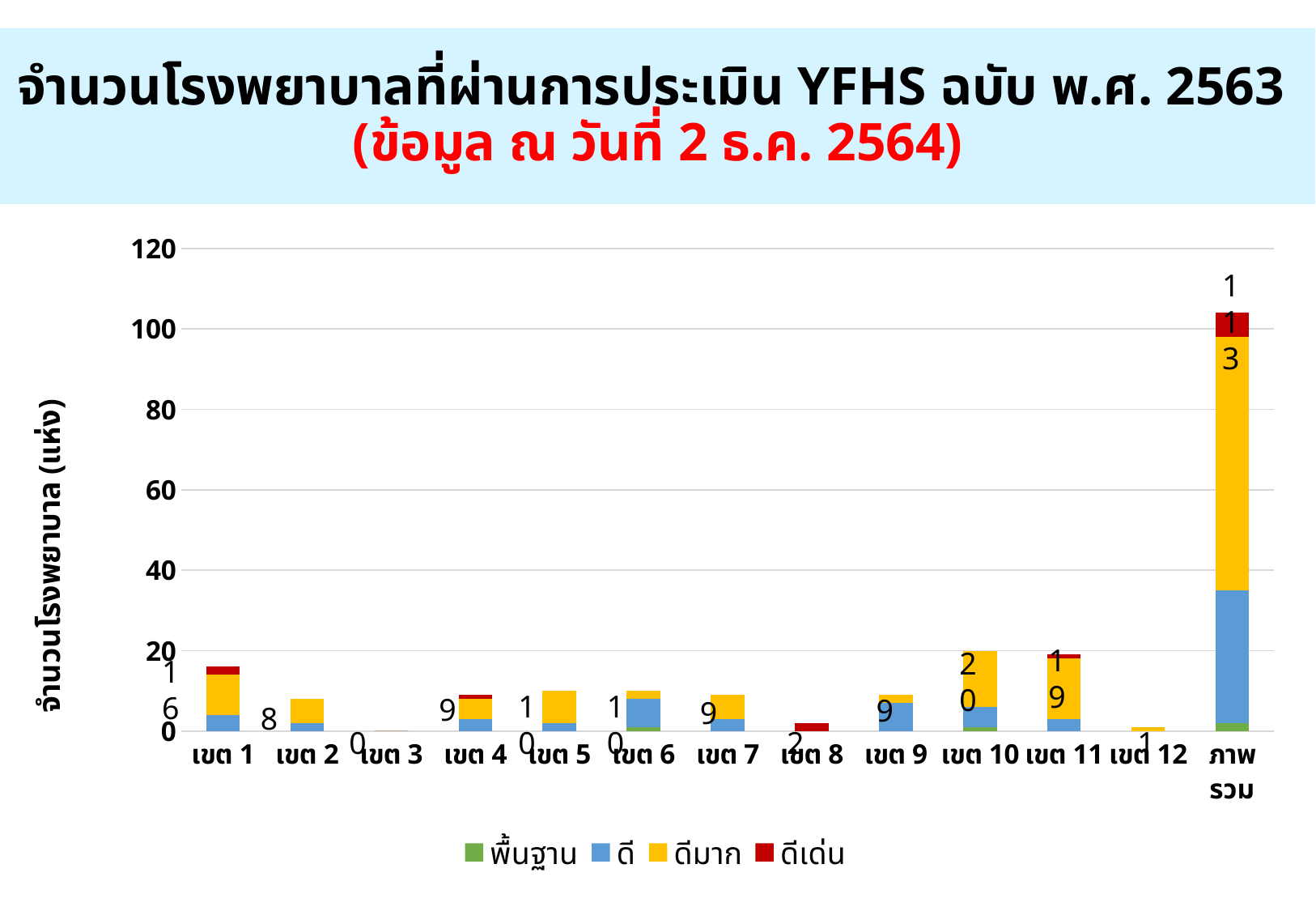
Which has the larger total, เขต 1 or เขต 8? เขต 1 How many series does the legend list? 4 What value is labelled on the bar for เขต 2? 8 Is the total for เขต 1 greater or less than 10? greater Which colour represents the series ดีเด่น in the legend? red Which category has the lowest total? เขต 3 How many categories are shown on the x axis? 13 Is the total for เขต 7 greater or less than 20? less Is the total for ภาพรวม greater or less than 100? greater What kind of chart is shown on the slide? stacked bar chart Which has the larger total, เขต 10 or เขต 2? เขต 10 Which category has the tallest bar? ภาพรวม